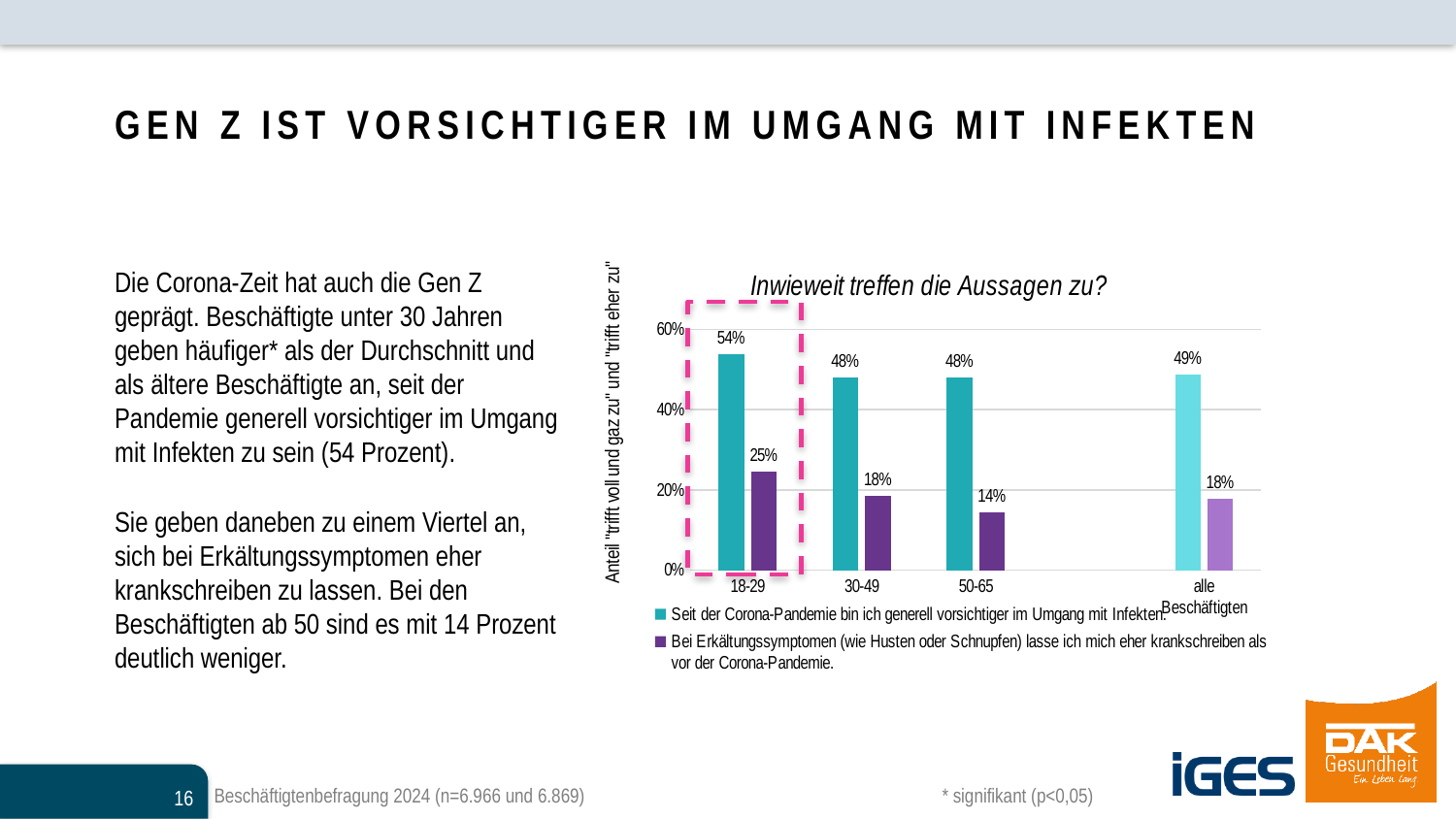
How many series does the chart's legend list? 2 What is the difference between the two series for the 18-29 group? 29 percentage points What is the value for the 50-65 group for the series "Bei Erkältungssymptomen ... lasse ich mich eher krankschreiben als vor der Corona-Pandemie"? 14% What is the value for "alle Beschäftigten" for the series "Seit der Corona-Pandemie bin ich generell vorsichtiger im Umgang mit Infekten"? 49% Which is larger: the value for 18-29 or the value for 30-49 for the series "Seit der Corona-Pandemie bin ich generell vorsichtiger im Umgang mit Infekten"? 18-29 How many categories are shown on the x axis of the chart? 4 What is the value for the 18-29 group for the series "Seit der Corona-Pandemie bin ich generell vorsichtiger im Umgang mit Infekten"? 54% What is the difference between the 18-29 group and the 50-65 group for the series "Bei Erkältungssymptomen ... lasse ich mich eher krankschreiben"? 11 percentage points Which age group has the highest value for the series "Bei Erkältungssymptomen ... lasse ich mich eher krankschreiben"? 18-29 Which category has the lowest value for the series "Bei Erkältungssymptomen ... lasse ich mich eher krankschreiben"? 50-65 Is the value for the 30-49 group for the series "Seit der Corona-Pandemie bin ich generell vorsichtiger im Umgang mit Infekten" greater or less than 40%? greater What type of chart is shown on the slide? Bar chart